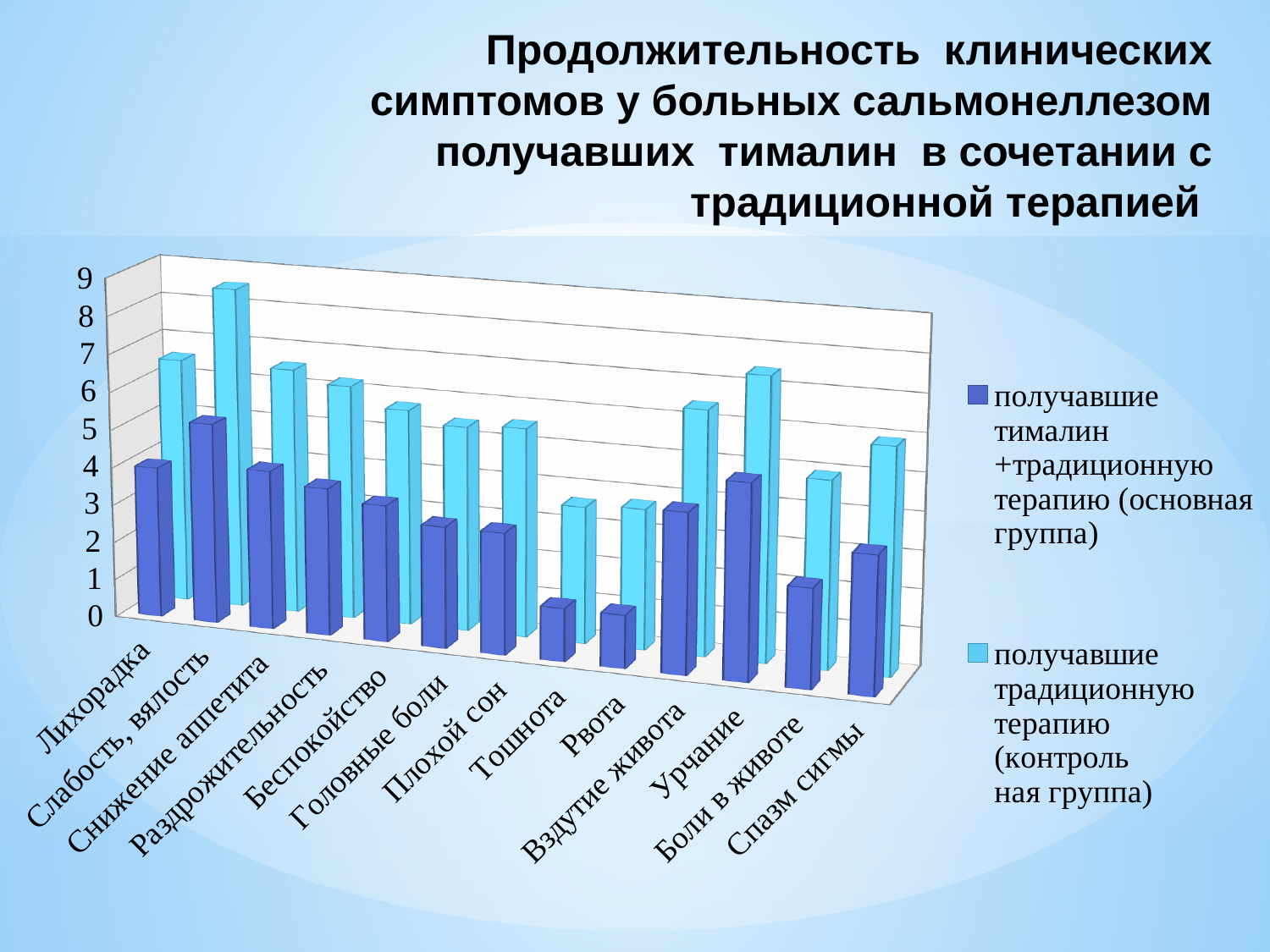
For 'Урчание', which series has the larger value: the основная группа or the контрольная группа? контрольная группа What kind of chart is shown on the slide? bar chart How many series does the chart legend list? 2 For 'Лихорадка', which series has the larger value: the основная группа or the контрольная группа? контрольная группа Which category has the highest value for the series 'получавшие тималин +традиционную терапию (основная группа)'? Слабость, вялость Which category has the highest value for the series 'получавшие традиционную терапию (контрольная группа)'? Слабость, вялость Which colour represents the series 'получавшие традиционную терапию (контрольная группа)' in the chart? light blue Is the value for 'Лихорадка' in the основная группа series greater or less than 3? greater Is the value for 'Тошнота' in the контрольная группа series greater or less than 5? less Is the value for 'Слабость, вялость' in the контрольная группа series greater or less than 8? greater How many symptom categories are shown on the x axis of the chart? 13